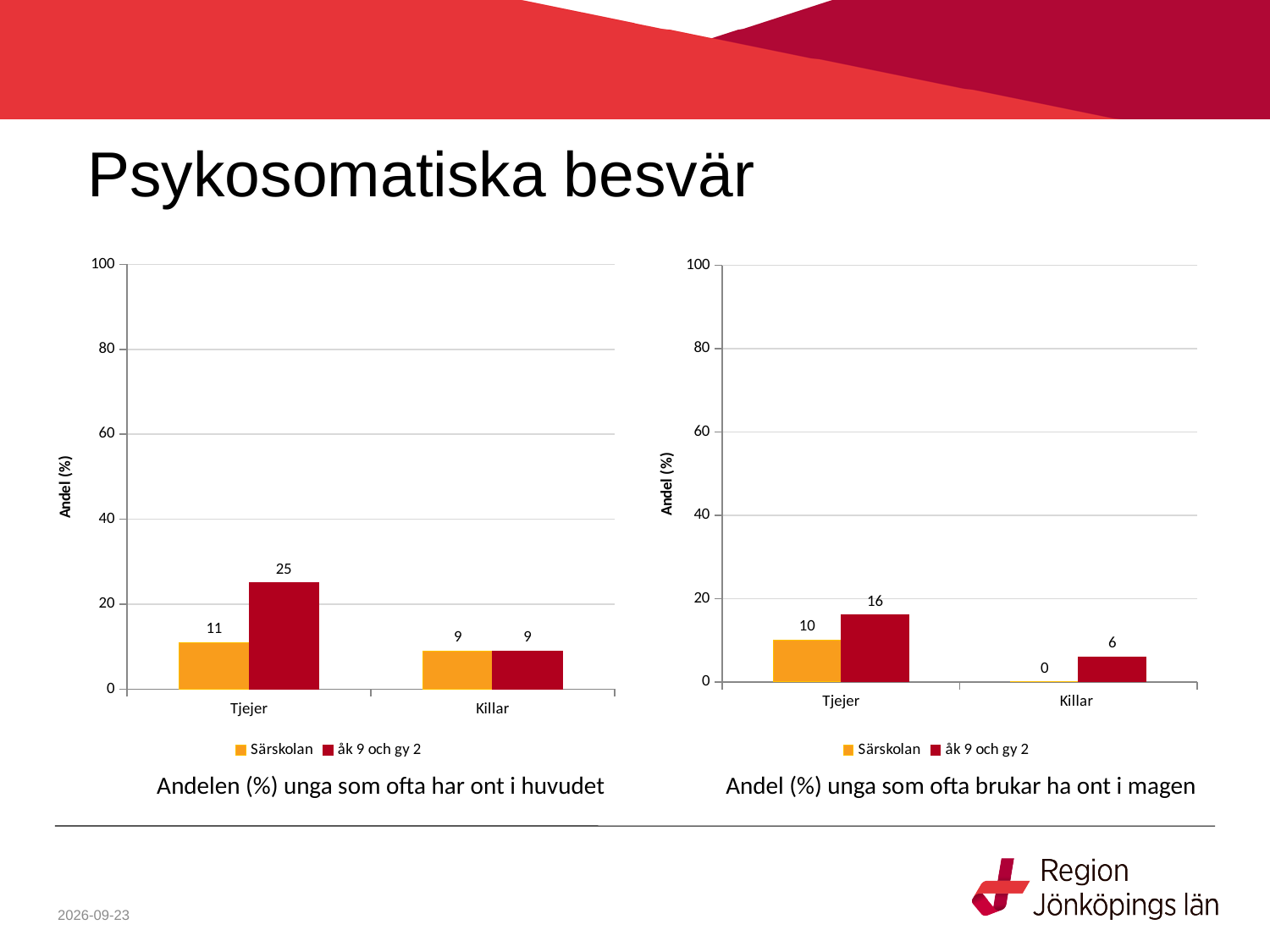
In the right chart (ont i magen), what is the value for åk 9 och gy 2 among Killar? 6 What kind of chart is the left chart (ont i huvudet)? Bar chart In the right chart (ont i magen), is the value for åk 9 och gy 2 among Tjejer greater or less than 20? less In the left chart (ont i huvudet), what is the difference between åk 9 och gy 2 and Särskolan among Tjejer? 14 How many categories are shown on the x axis of the right chart (ont i magen)? 2 In the left chart (ont i huvudet), what is the value for Särskolan among Tjejer? 11 In the right chart (ont i magen), which is larger among Tjejer: Särskolan or åk 9 och gy 2? åk 9 och gy 2 In the right chart (ont i magen), what is the difference between åk 9 och gy 2 and Särskolan among Tjejer? 6 How many series does the legend of the left chart (ont i huvudet) list? 2 In the right chart (ont i magen), what is the value for Särskolan among Killar? 0 In the left chart (ont i huvudet), what is the value for åk 9 och gy 2 among Tjejer? 25 In the left chart (ont i huvudet), which category has the highest value for åk 9 och gy 2? Tjejer